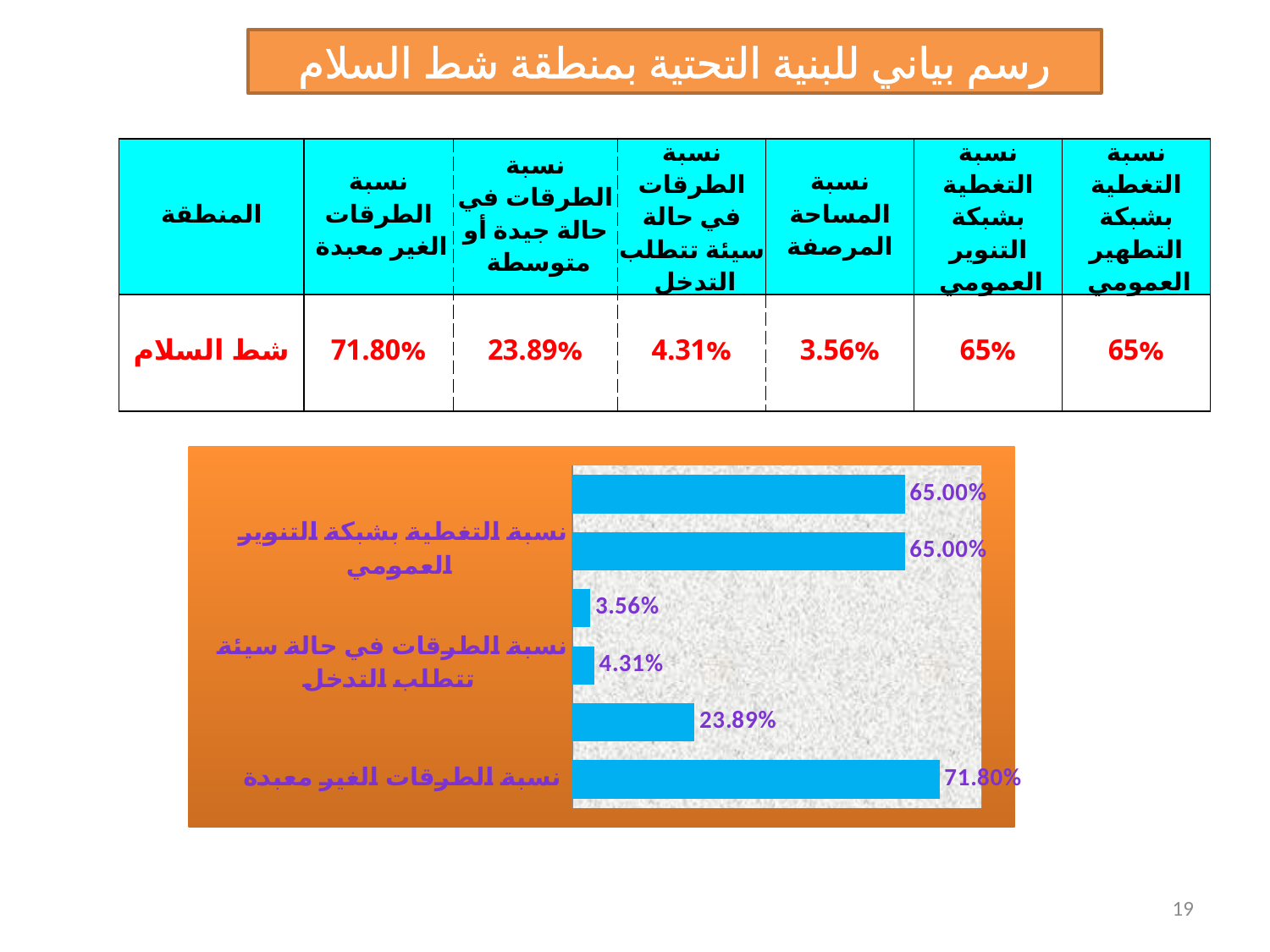
Which is larger: the bar for نسبة الطرقات الغير معبدة or the bar for نسبة التغطية بشبكة التنوير العمومي? نسبة الطرقات الغير معبدة What is the largest value shown on any bar in the chart? 71.80% Which category has the longest bar in the chart? نسبة الطرقات الغير معبدة What is the smallest value shown on any bar in the chart? 3.56% What is the value of the bar labelled نسبة الطرقات في حالة سيئة تتطلب التدخل? 4.31% What is the value of the bar labelled نسبة الطرقات الغير معبدة? 71.80% What kind of chart is shown on the slide? Bar chart What is the title shown at the top of the slide above the chart? رسم بياني للبنية التحتية بمنطقة شط السلام What is the difference between the bar for نسبة الطرقات الغير معبدة (71.80%) and the bar directly above it (23.89%)? 47.91% How many bars are plotted in the chart? 6 What is the difference between the bar for نسبة التغطية بشبكة التنوير العمومي and the bar for نسبة الطرقات في حالة سيئة تتطلب التدخل? 60.69% What is the value of the bar labelled نسبة التغطية بشبكة التنوير العمومي? 65.00%